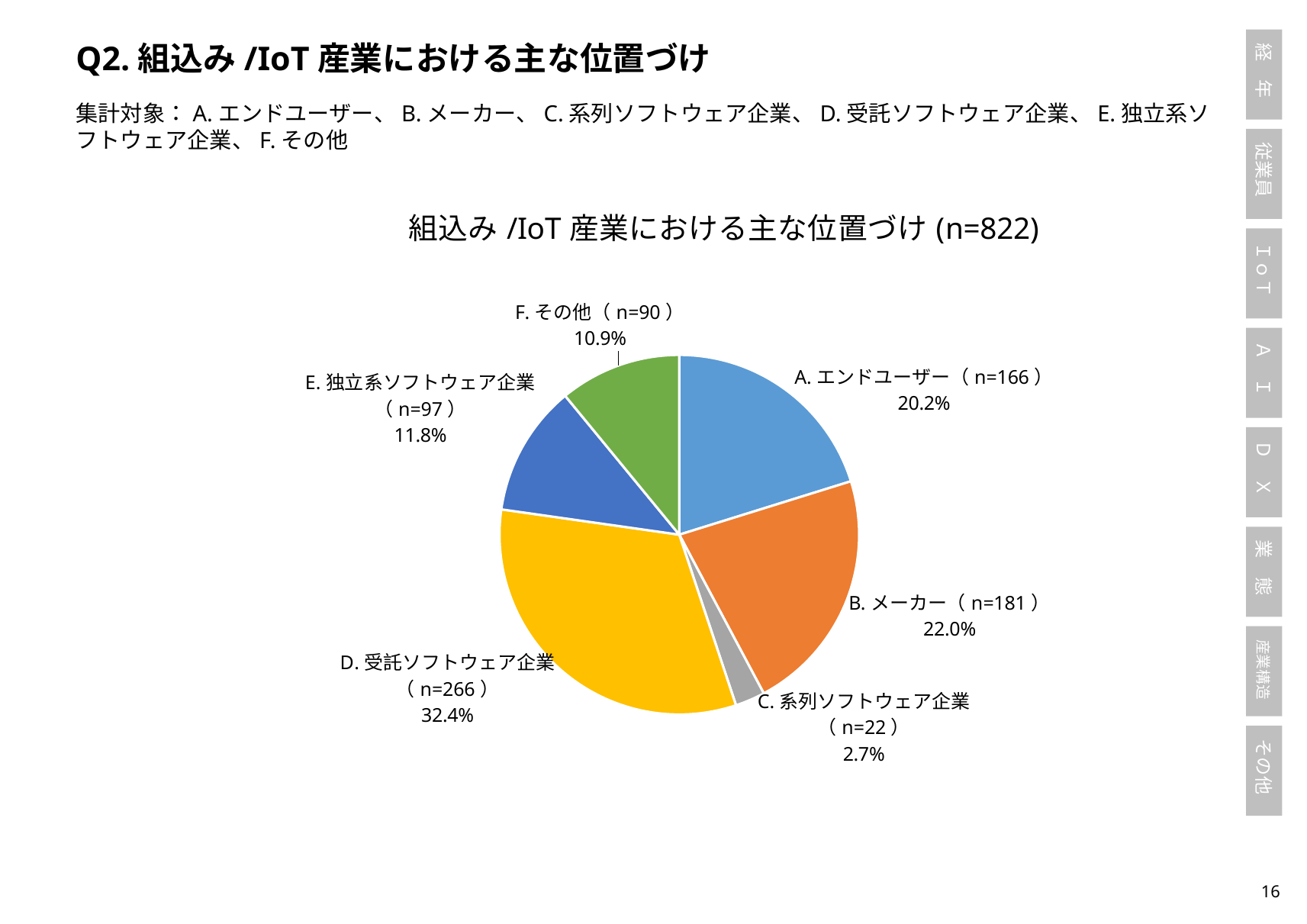
What percentage is shown for A. エンドユーザー? 20.2% Which category has the largest slice of the pie? D. 受託ソフトウェア企業 What is the difference in n between D. 受託ソフトウェア企業 and B. メーカー? 85 How many categories are shown in the pie chart? 6 Which category has the smallest slice of the pie? C. 系列ソフトウェア企業 What percentage share does D. 受託ソフトウェア企業 have in the pie chart? 32.4% What is the n value for C. 系列ソフトウェア企業? 22 Which has a larger share, E. 独立系ソフトウェア企業 or F. その他? E. 独立系ソフトウェア企業 What is the total n shown in the chart title? 822 What is the n value for B. メーカー? 181 What kind of chart is shown on the slide? pie chart What is the difference in percentage points between A. エンドユーザー and B. メーカー? 1.8%